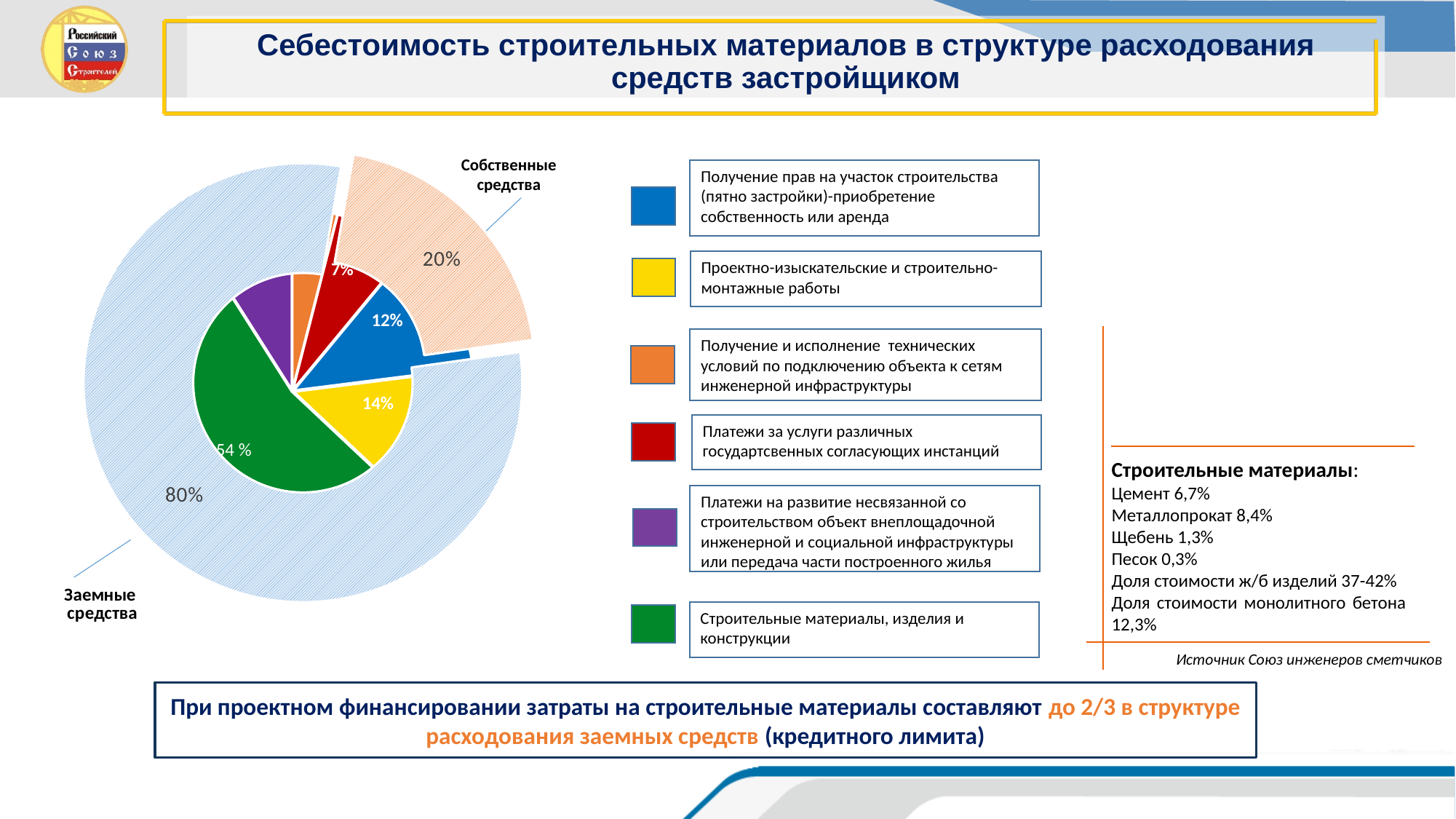
Which category has the smallest slice in the pie chart? Получение и исполнение технических условий по подключению объекта к сетям инженерной инфраструктуры What type of chart is shown on the slide? Pie chart What percentage does the pie chart show for "Платежи за услуги различных государственных согласующих инстанций"? 7% What share does the outer ring of the chart show for "Собственные средства"? 20% What percentage does the pie chart show for "Строительные материалы, изделия и конструкции"? 54 % Which category has the largest slice in the pie chart? Строительные материалы, изделия и конструкции What share does the outer ring of the chart show for "Заемные средства"? 80% How many categories does the legend of the pie chart list? 6 By how many percentage points does the "Строительные материалы, изделия и конструкции" slice exceed the "Проектно-изыскательские и строительно-монтажные работы" slice? 40 percentage points Which is larger in the pie chart: the slice for "Получение прав на участок строительства" or the slice for "Проектно-изыскательские и строительно-монтажные работы"? Проектно-изыскательские и строительно-монтажные работы What percentage does the pie chart show for "Проектно-изыскательские и строительно-монтажные работы"? 14% What percentage does the pie chart show for "Получение прав на участок строительства (пятно застройки)"? 12%